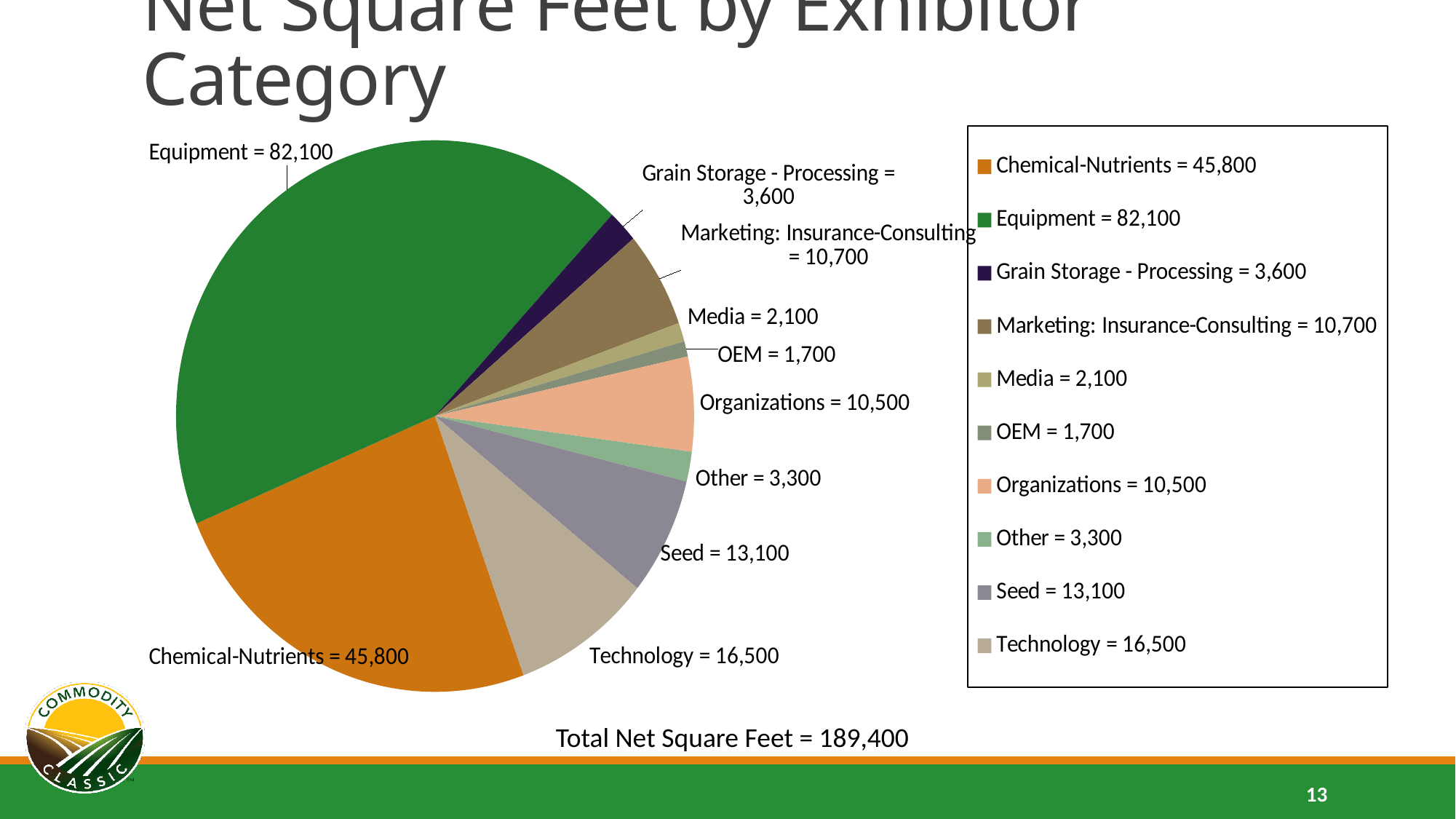
What is the total net square feet stated on the slide? 189,400 What is the net square feet value for Grain Storage - Processing? 3,600 What is the difference in net square feet between Chemical-Nutrients and Technology? 29,300 Which has more net square feet, Marketing: Insurance-Consulting or Organizations? Marketing: Insurance-Consulting What is the net square feet value for Equipment? 82,100 What is the net square feet value for Seed? 13,100 Which exhibitor category has the smallest net square feet? OEM What kind of chart is shown on the slide? Pie chart What is the difference in net square feet between Equipment and Chemical-Nutrients? 36,300 Which exhibitor category has the largest net square feet? Equipment How many exhibitor categories are shown in the pie chart? 10 What colour is the Equipment slice of the pie chart? Green